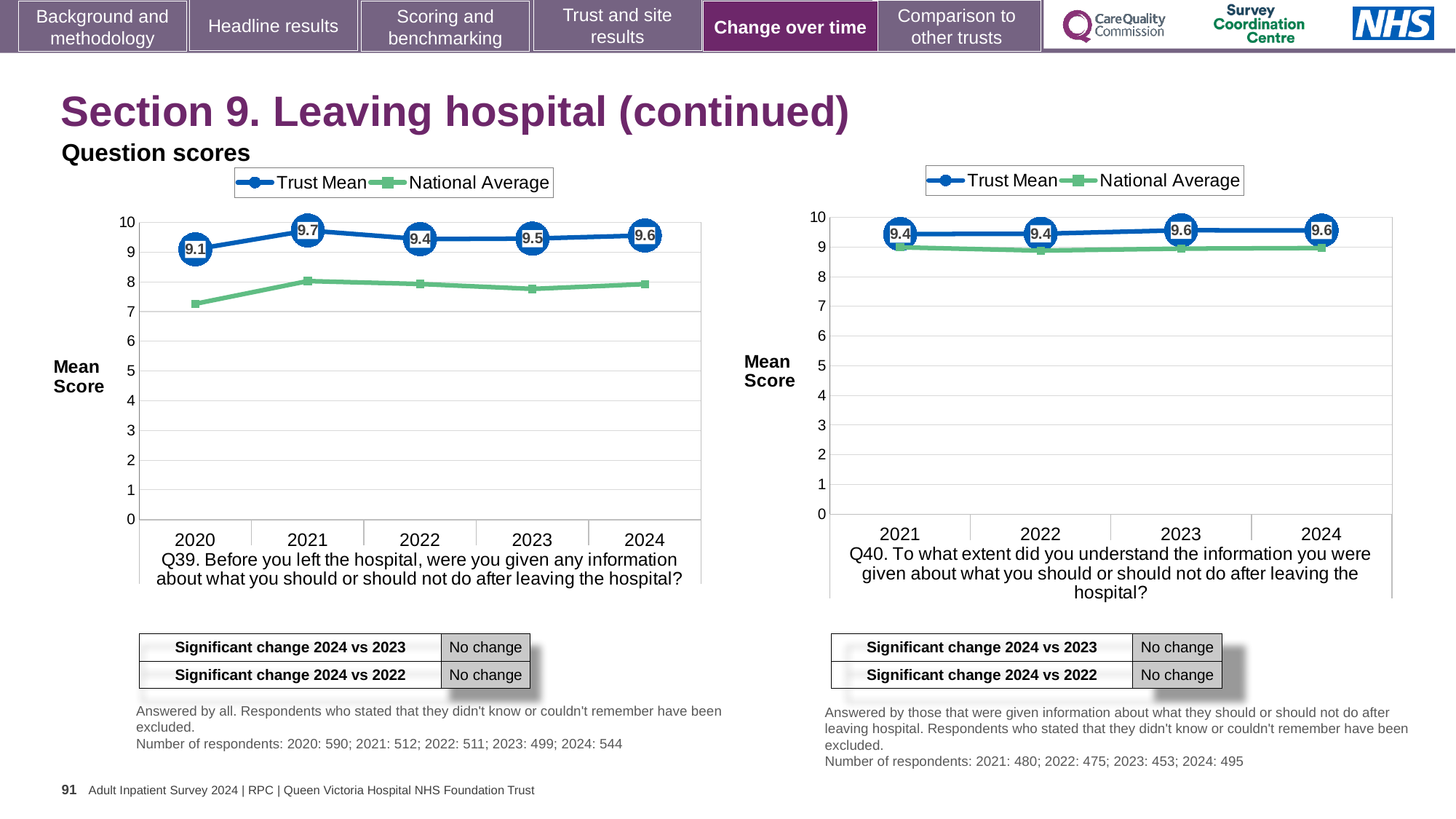
What kind of chart is the Q40 chart on the right? Line chart How many years are plotted on the x axis of the Q40 chart on the right? 4 In the Q39 chart on the left, what is the difference between the Trust Mean scores for 2021 and 2020? 0.6 In the Q40 chart on the right, what is the difference between the Trust Mean scores for 2024 and 2021? 0.2 In the Q39 chart on the left, is the National Average for 2020 greater or less than 8? less In the Q39 chart on the left, which is larger in 2024, the Trust Mean or the National Average? Trust Mean In the Q39 chart on the left, which year has the lowest Trust Mean score? 2020 In the Q40 chart on the right, what is the Trust Mean score for 2024? 9.6 In the Q39 chart on the left, what is the Trust Mean score for 2020? 9.1 In the Q39 chart on the left, what is the Trust Mean score for 2021? 9.7 In the Q39 chart on the left, which year has the highest Trust Mean score? 2021 How many series does the legend of the Q39 chart on the left list? 2